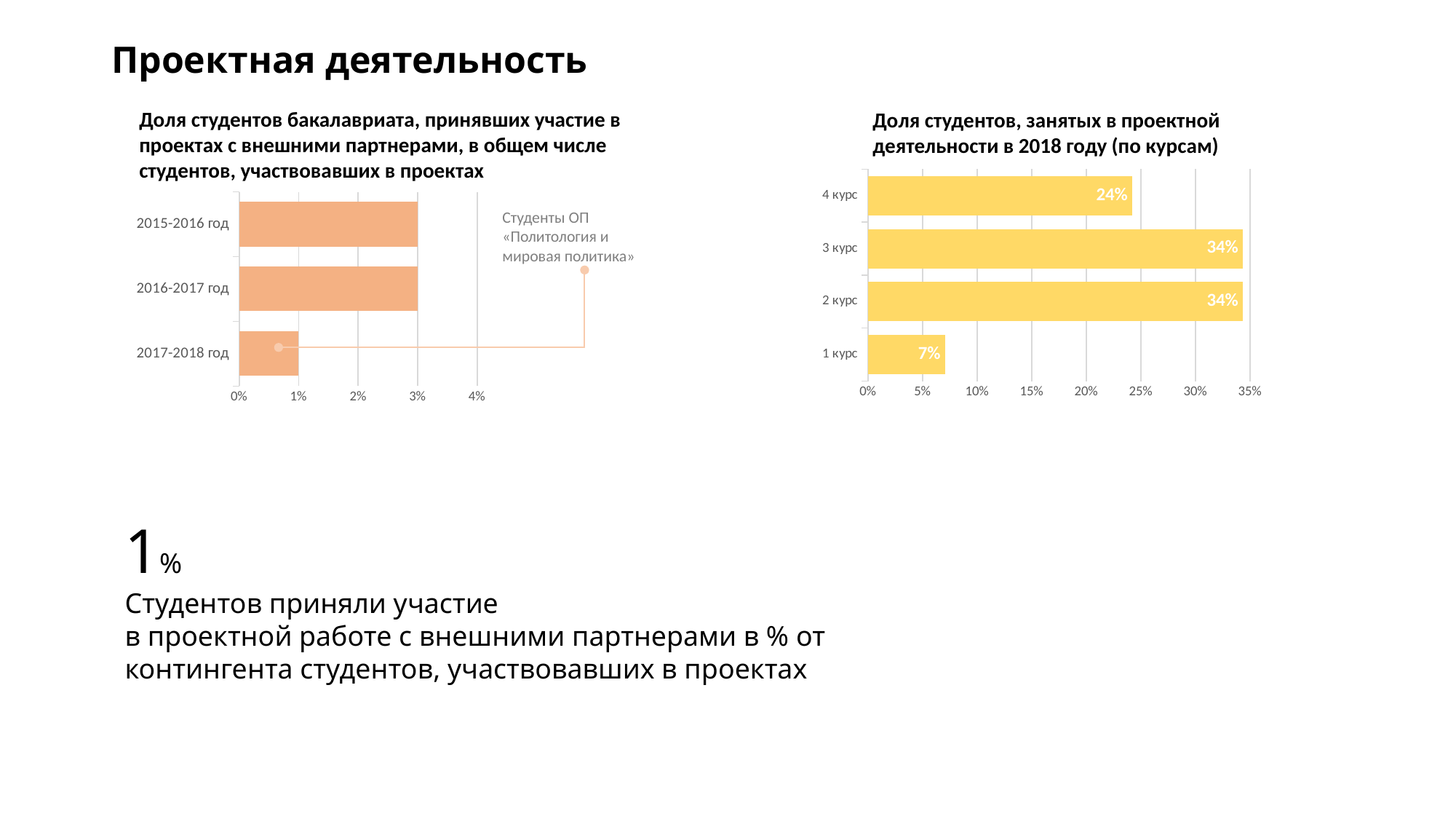
In the left chart (Доля студентов бакалавриата, принявших участие в проектах с внешними партнерами), what is the value for 2017-2018 год? 1% In the right chart (Доля студентов, занятых в проектной деятельности в 2018 году), which is larger, the value for 4 курс or 1 курс? 4 курс What type of chart is the right chart (Доля студентов, занятых в проектной деятельности в 2018 году)? Bar chart In the left chart (Доля студентов бакалавриата, принявших участие в проектах с внешними партнерами), is the value for 2016-2017 год greater or less than 2%? greater In the right chart (Доля студентов, занятых в проектной деятельности в 2018 году), which course has the lowest share? 1 курс In the right chart (Доля студентов, занятых в проектной деятельности в 2018 году), what is the value for 4 курс? 24% In the left chart (Доля студентов бакалавриата, принявших участие в проектах с внешними партнерами), how many years are shown? 3 In the right chart (Доля студентов, занятых в проектной деятельности в 2018 году), what is the difference between the values for 3 курс and 4 курс? 10% In the left chart (Доля студентов бакалавриата, принявших участие в проектах с внешними партнерами), which year has the lowest value? 2017-2018 год In the right chart (Доля студентов, занятых в проектной деятельности в 2018 году), how many courses are shown? 4 In the right chart (Доля студентов, занятых в проектной деятельности в 2018 году), what is the value for 1 курс? 7% In the left chart (Доля студентов бакалавриата, принявших участие в проектах с внешними партнерами), what is the value for 2015-2016 год? 3%